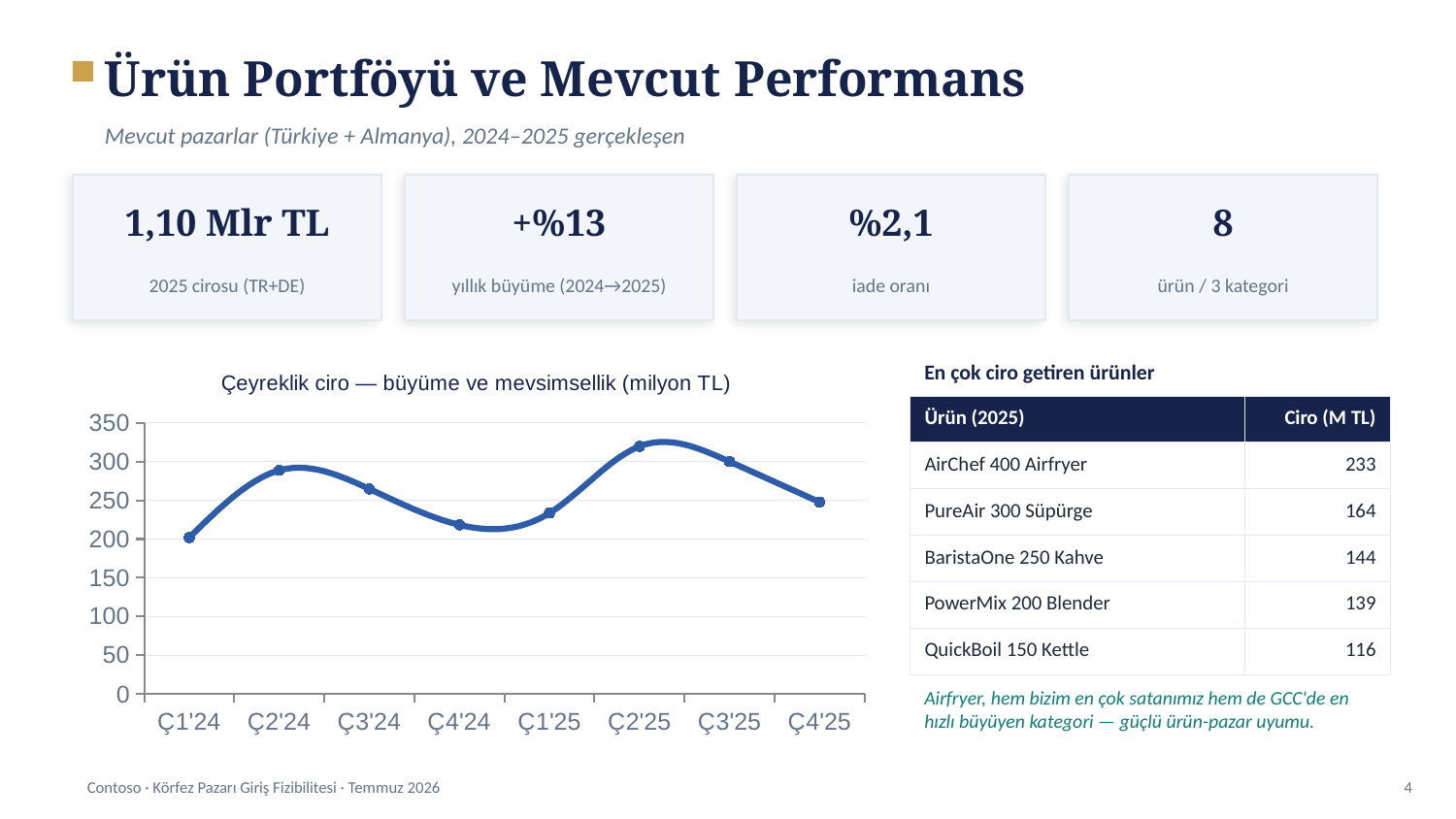
Is the value for Ç2'25 greater or less than 300? greater Which is larger, the value for Ç2'25 or the value for Ç4'25? Ç2'25 Is the value for Ç2'24 greater or less than 250? greater Which quarter has the lowest value in the chart? Ç1'24 How many quarters are plotted on the x axis of the chart? 8 Do the values rise or fall from Ç2'25 to Ç4'25? fall What is the title of the chart? Çeyreklik ciro — büyüme ve mevsimsellik (milyon TL) Is the value for Ç4'24 greater or less than 250? less Which quarter has the highest value in the chart? Ç2'25 What kind of chart is shown on the slide? line chart Which is larger, the value for Ç2'24 or the value for Ç1'24? Ç2'24